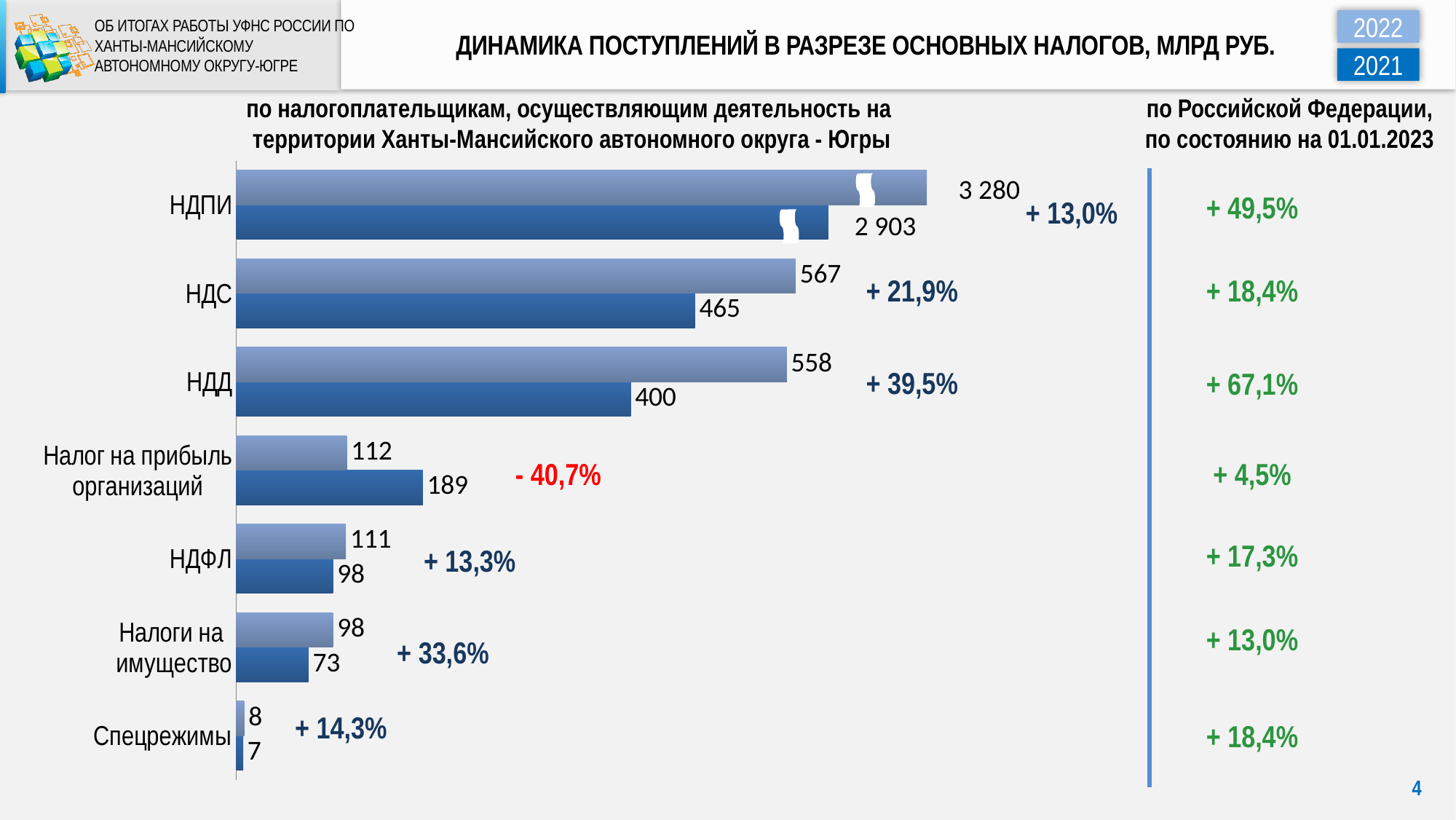
Which is larger for Налог на прибыль организаций: the 2022 value or the 2021 value? 2021 Which tax category has the lowest value in 2021? Спецрежимы What was the value for Налог на прибыль организаций in 2022? 112 How many series (years) does the chart compare? 2 What was the value for НДПИ in 2022? 3 280 Which tax category has the highest value in 2022? НДПИ How many tax categories are shown in the chart? 7 What kind of chart is shown on the slide? bar chart What was the value for НДС in 2021? 465 What percentage change is shown for Налоги на имущество in the Khanty-Mansi region? + 33,6% Which year does the dark blue series represent according to the legend? 2021 What is the difference between the 2022 and 2021 values for НДД? 158